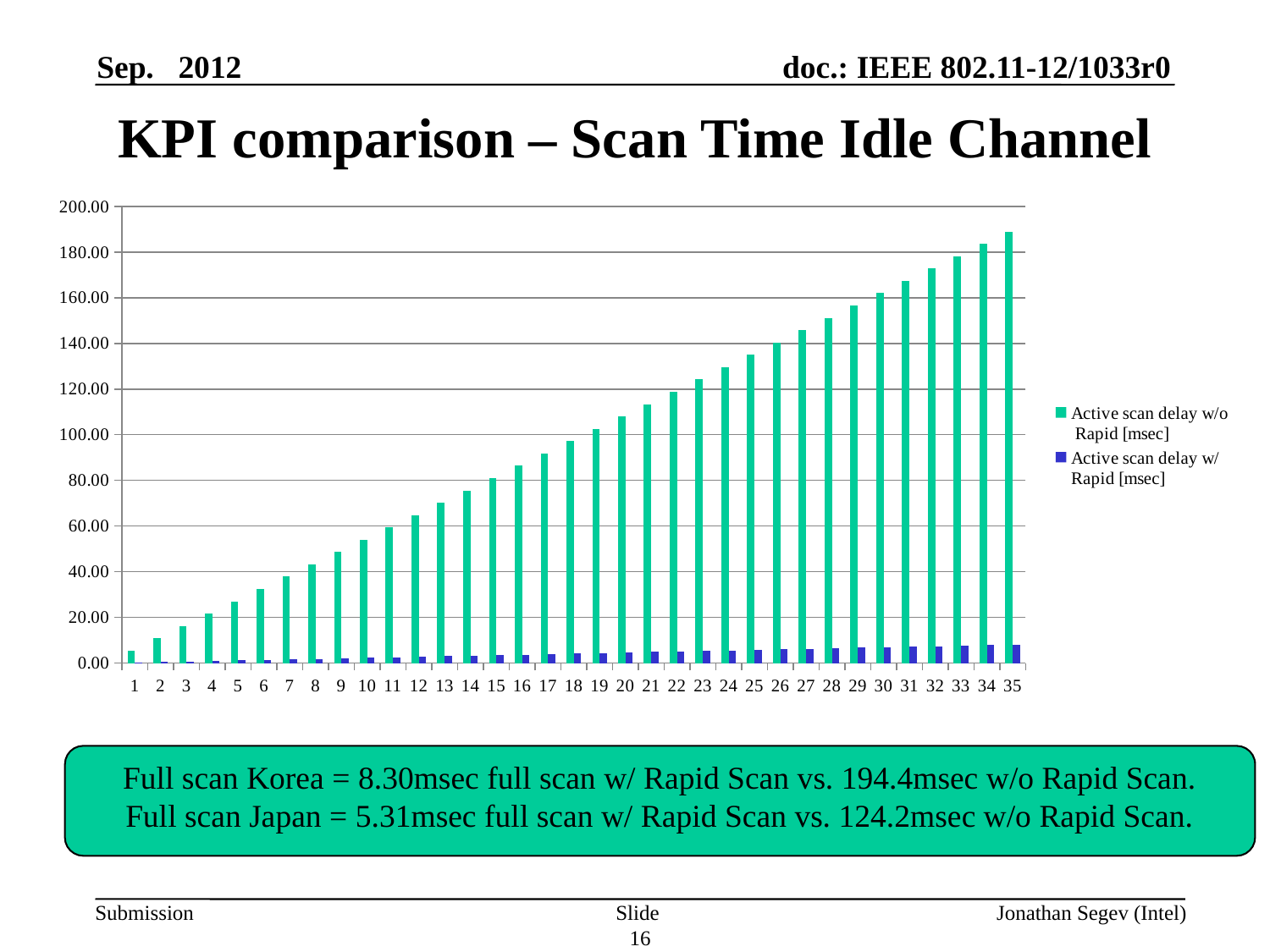
What kind of chart is shown on the slide? bar chart Is the value for 'Active scan delay w/o Rapid [msec]' at category 20 greater or less than 100? greater How many series does the legend list? 2 What is the title of the slide containing the chart? KPI comparison – Scan Time Idle Channel How many categories are shown along the x axis? 35 Is the value for 'Active scan delay w/o Rapid [msec]' at category 35 greater or less than 180? greater Which category has the lowest value for 'Active scan delay w/o Rapid [msec]'? 1 At category 35, which series has the larger value: 'Active scan delay w/o Rapid [msec]' or 'Active scan delay w/ Rapid [msec]'? Active scan delay w/o Rapid [msec] Is the value for 'Active scan delay w/o Rapid [msec]' at category 25 greater or less than 140? less Do the values for 'Active scan delay w/o Rapid [msec]' rise or fall as the category number increases along the x axis? rise Which category has the highest value for 'Active scan delay w/o Rapid [msec]'? 35